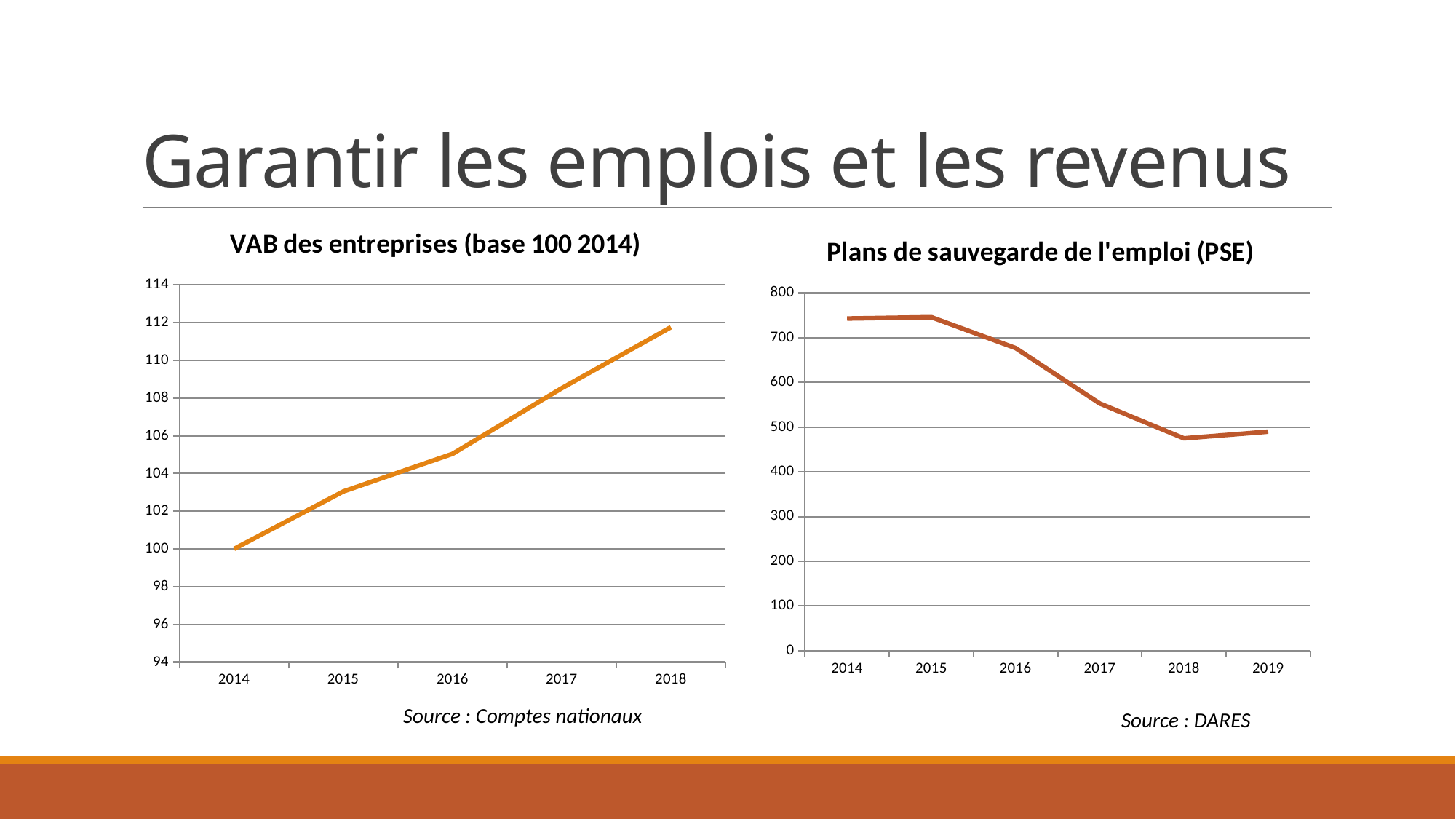
On the 'VAB des entreprises (base 100 2014)' chart, which year has the highest value? 2018 On the 'VAB des entreprises (base 100 2014)' chart, what is the value for 2014? 100 What kind of chart is the 'VAB des entreprises (base 100 2014)' chart? line chart How many years are plotted on the 'VAB des entreprises (base 100 2014)' chart? 5 On the 'Plans de sauvegarde de l'emploi (PSE)' chart, which is larger, the value for 2016 or the value for 2017? 2016 On the 'VAB des entreprises (base 100 2014)' chart, do the values rise or fall from 2014 to 2018? rise What source is cited under the 'Plans de sauvegarde de l'emploi (PSE)' chart? DARES On the 'VAB des entreprises (base 100 2014)' chart, is the value for 2018 greater or less than 110? greater On the 'Plans de sauvegarde de l'emploi (PSE)' chart, is the value for 2014 greater or less than 700? greater How many years are plotted on the 'Plans de sauvegarde de l'emploi (PSE)' chart? 6 On the 'Plans de sauvegarde de l'emploi (PSE)' chart, do the values rise or fall from 2015 to 2018? fall On the 'Plans de sauvegarde de l'emploi (PSE)' chart, is the value for 2018 greater or less than 500? less